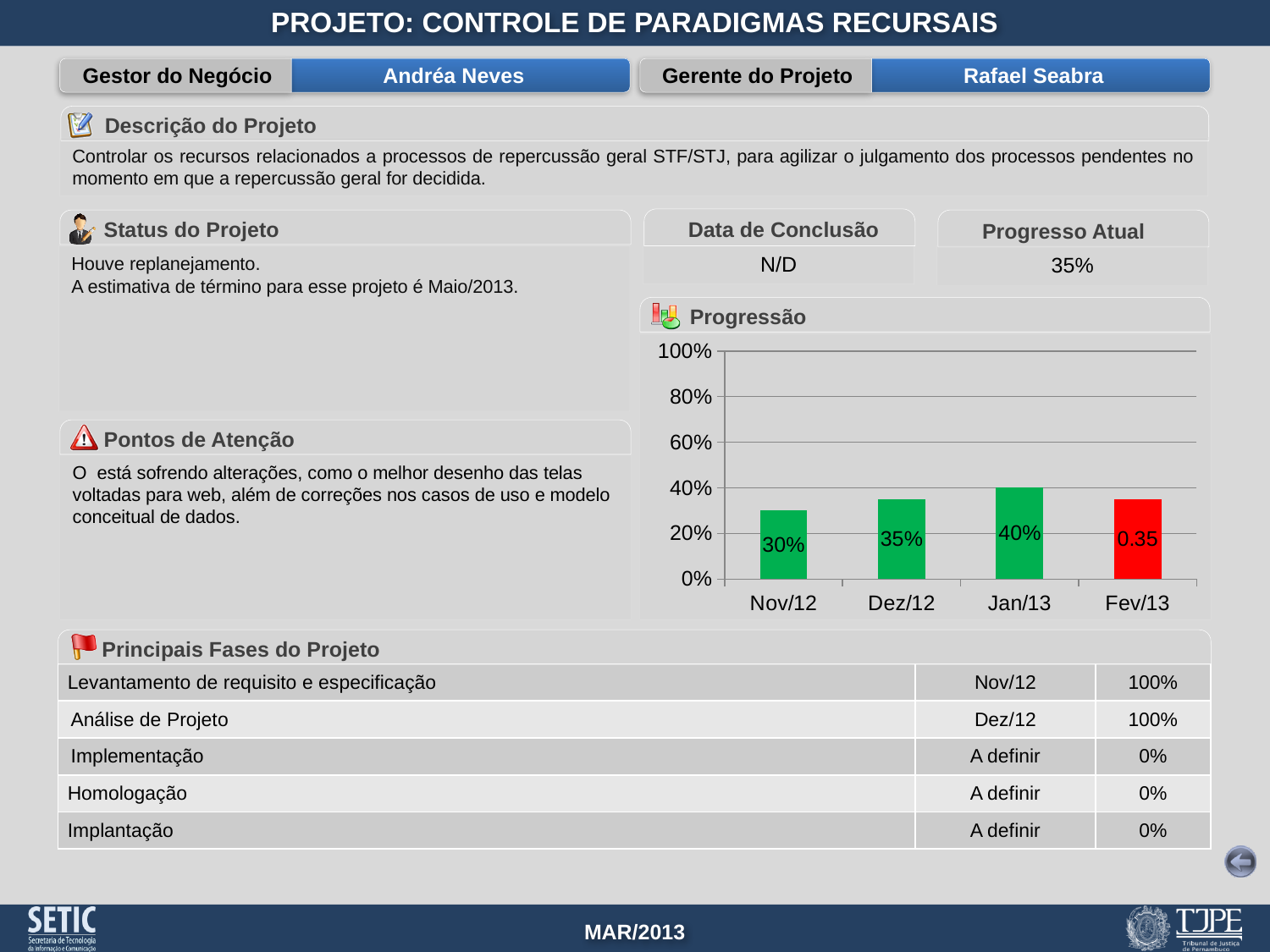
What is the value shown for Jan/13 in the Progressão chart? 40% How many months are shown on the x axis of the Progressão chart? 4 What kind of chart is the Progressão chart? bar chart What data label is printed on the Fev/13 bar in the Progressão chart? 0.35 What is the value shown for Dez/12 in the Progressão chart? 35% In the Progressão chart, which is larger: the value for Jan/13 or the value for Dez/12? Jan/13 What is the value shown for Nov/12 in the Progressão chart? 30% What is the difference between the Jan/13 and Nov/12 values in the Progressão chart? 10 percentage points Which month has the lowest bar in the Progressão chart? Nov/12 What colour is the Fev/13 bar in the Progressão chart? red In the Progressão chart, is the value for Nov/12 greater or less than 40%? less Which month has the highest bar in the Progressão chart? Jan/13